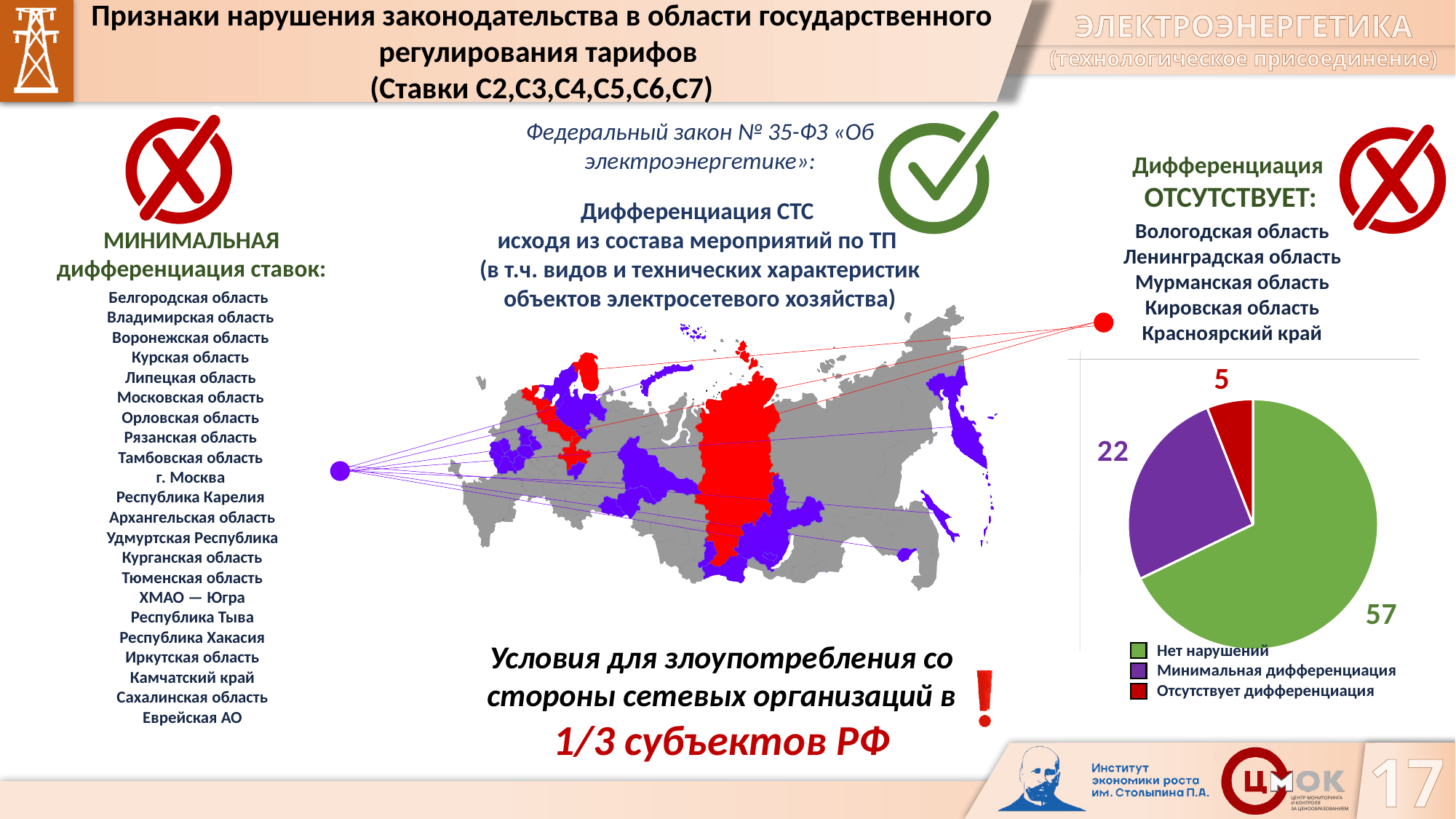
In the pie chart, what is the value for "Нет нарушений"? 57 How many slices does the pie chart have? 3 What kind of chart is shown on the right side of the slide? pie chart In the pie chart, what is the difference between the values for "Нет нарушений" and "Минимальная дифференциация"? 35 What colour is the "Отсутствует дифференциация" slice in the pie chart? red Which category has the largest slice in the pie chart? Нет нарушений In the pie chart, what is the value for "Отсутствует дифференциация"? 5 Which category has the smallest slice in the pie chart? Отсутствует дифференциация In the pie chart, what is the value for "Минимальная дифференциация"? 22 In the pie chart, which is larger: "Минимальная дифференциация" or "Отсутствует дифференциация"? Минимальная дифференциация In the pie chart, what is the difference between the values for "Минимальная дифференциация" and "Отсутствует дифференциация"? 17 What is the total of all values shown in the pie chart? 84